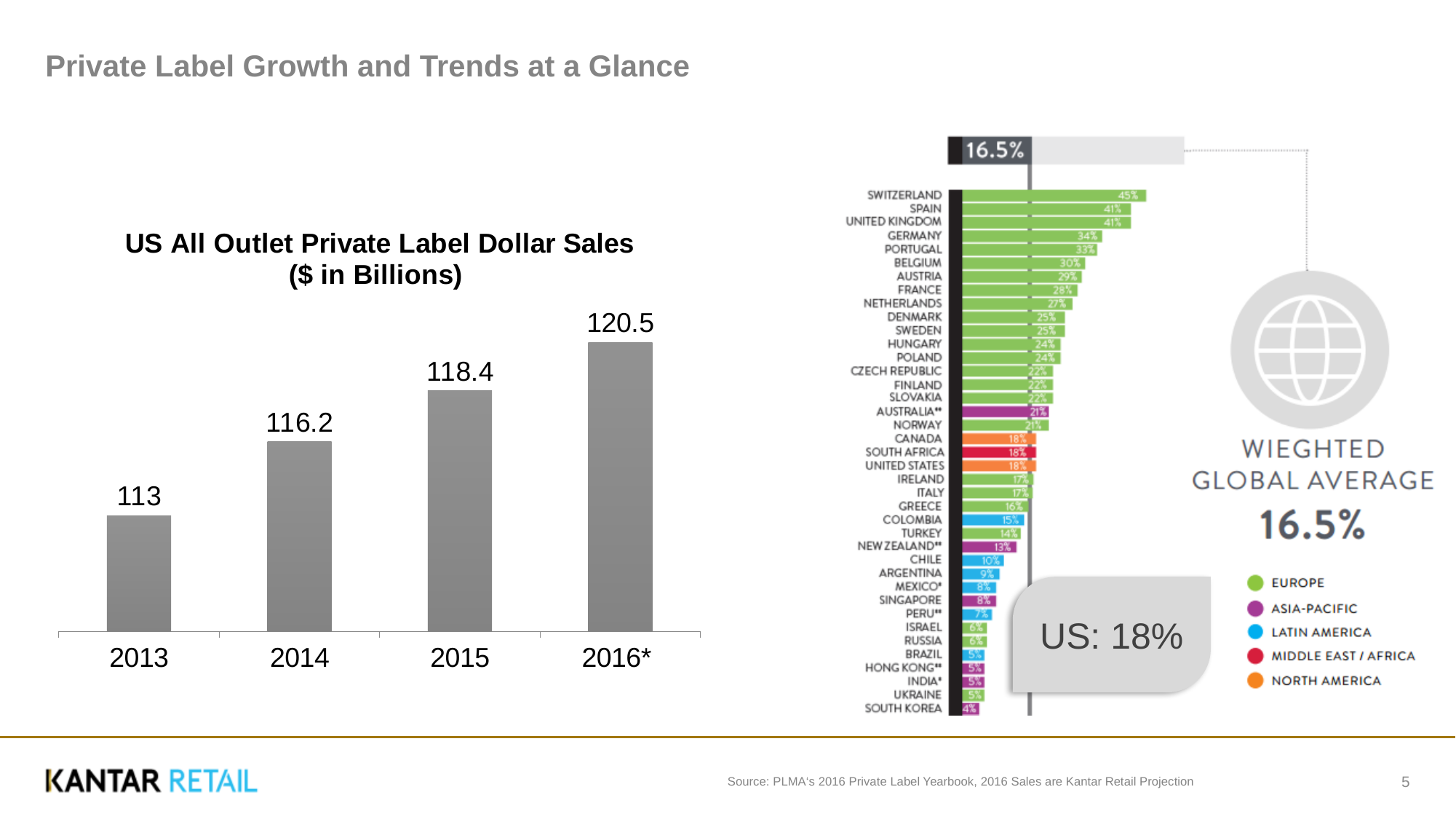
In the US All Outlet Private Label Dollar Sales chart, what is the difference between the 2016* and 2014 values? 4.3 What kind of chart is the US All Outlet Private Label Dollar Sales chart? bar chart How many regions does the legend of the country chart on the right list? 5 How many years are shown in the US All Outlet Private Label Dollar Sales chart? 4 In the US All Outlet Private Label Dollar Sales chart, what is the value for 2015? 118.4 In the US All Outlet Private Label Dollar Sales chart, do the values rise or fall from 2013 to 2016*? rise In the US All Outlet Private Label Dollar Sales chart, which year has the highest value? 2016* In the country chart on the right, which country has the lowest private label share? South Korea In the country chart on the right, what is the value for the United States? 18% In the country chart on the right, what is the weighted global average shown? 16.5% In the country chart on the right, which country has the highest private label share? Switzerland In the US All Outlet Private Label Dollar Sales chart, what is the value for 2013? 113